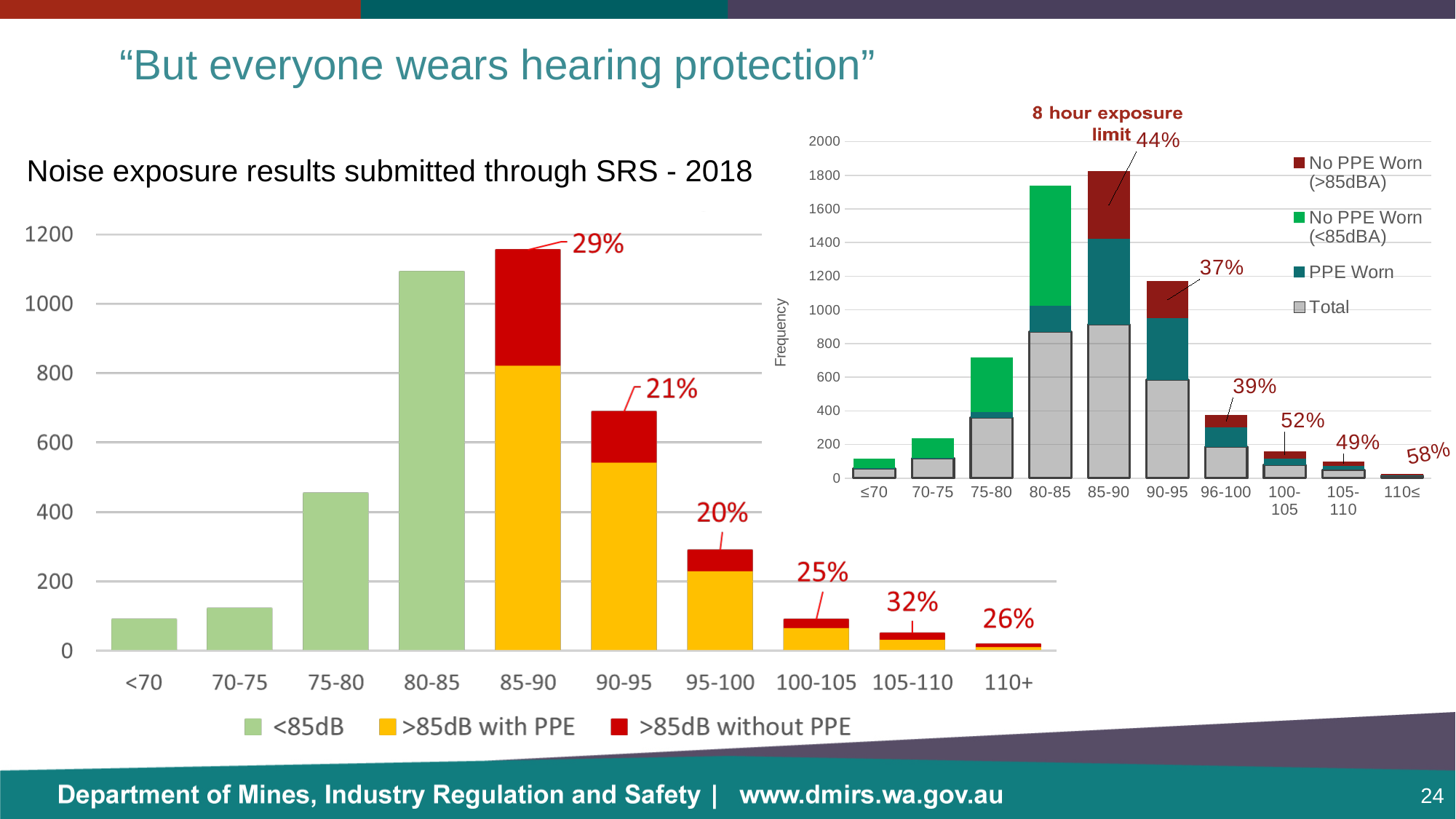
On the left chart titled "Noise exposure results submitted through SRS - 2018", how many series does the legend list? 3 On the right-hand chart with the "8 hour exposure limit" annotation, how many series does the legend list? 4 On the left chart titled "Noise exposure results submitted through SRS - 2018", is the value for 75-80 greater or less than 600? less On the left chart titled "Noise exposure results submitted through SRS - 2018", what percentage label is shown above the 105-110 bar? 32% On the left chart titled "Noise exposure results submitted through SRS - 2018", is the total height of the 80-85 bar greater or less than 1000? greater On the right-hand chart with the "8 hour exposure limit" annotation, what is the label on the vertical axis? Frequency On the right-hand chart with the "8 hour exposure limit" annotation, which category has the highest percentage label? 110≤ On the left chart titled "Noise exposure results submitted through SRS - 2018", what percentage label is shown above the 85-90 bar? 29% On the left chart titled "Noise exposure results submitted through SRS - 2018", what kind of chart is it? Stacked bar chart On the left chart titled "Noise exposure results submitted through SRS - 2018", which category has the lowest percentage label? 95-100 On the right-hand chart with the "8 hour exposure limit" annotation, what percentage label is shown for the 85-90 bar? 44% On the left chart titled "Noise exposure results submitted through SRS - 2018", how many categories are shown on the x axis? 10